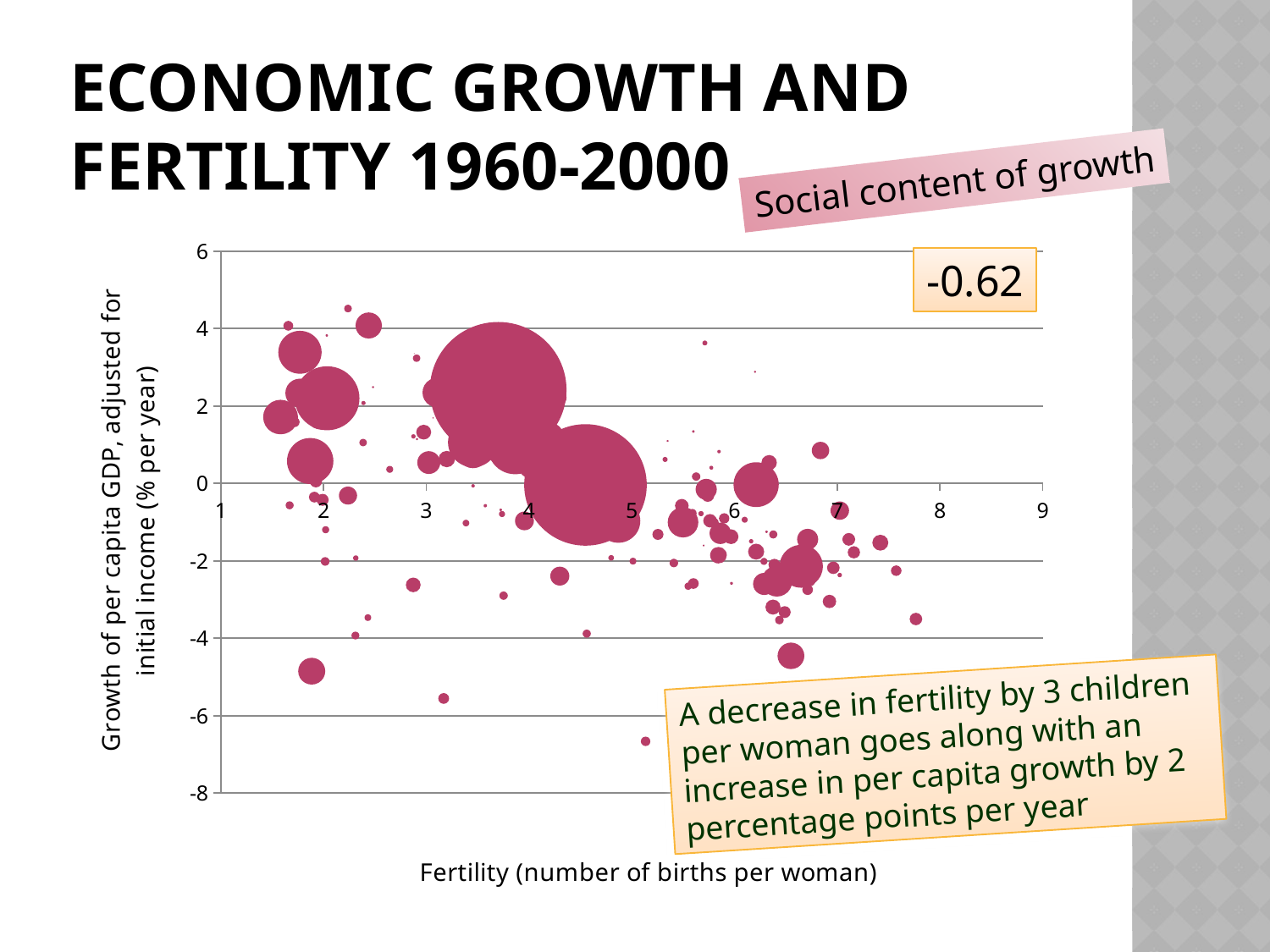
Is the growth value for the largest bubble on the chart greater or less than 0? greater Is the fertility value for the largest bubble on the chart greater or less than 3? greater Is the growth value for the highest bubble on the chart greater or less than 4? greater What kind of chart is shown on the slide? bubble chart What number is shown in the box at the top right of the chart? -0.62 As fertility increases along the x axis, do the growth values generally rise or fall? fall What is the label of the x axis? Fertility (number of births per woman)